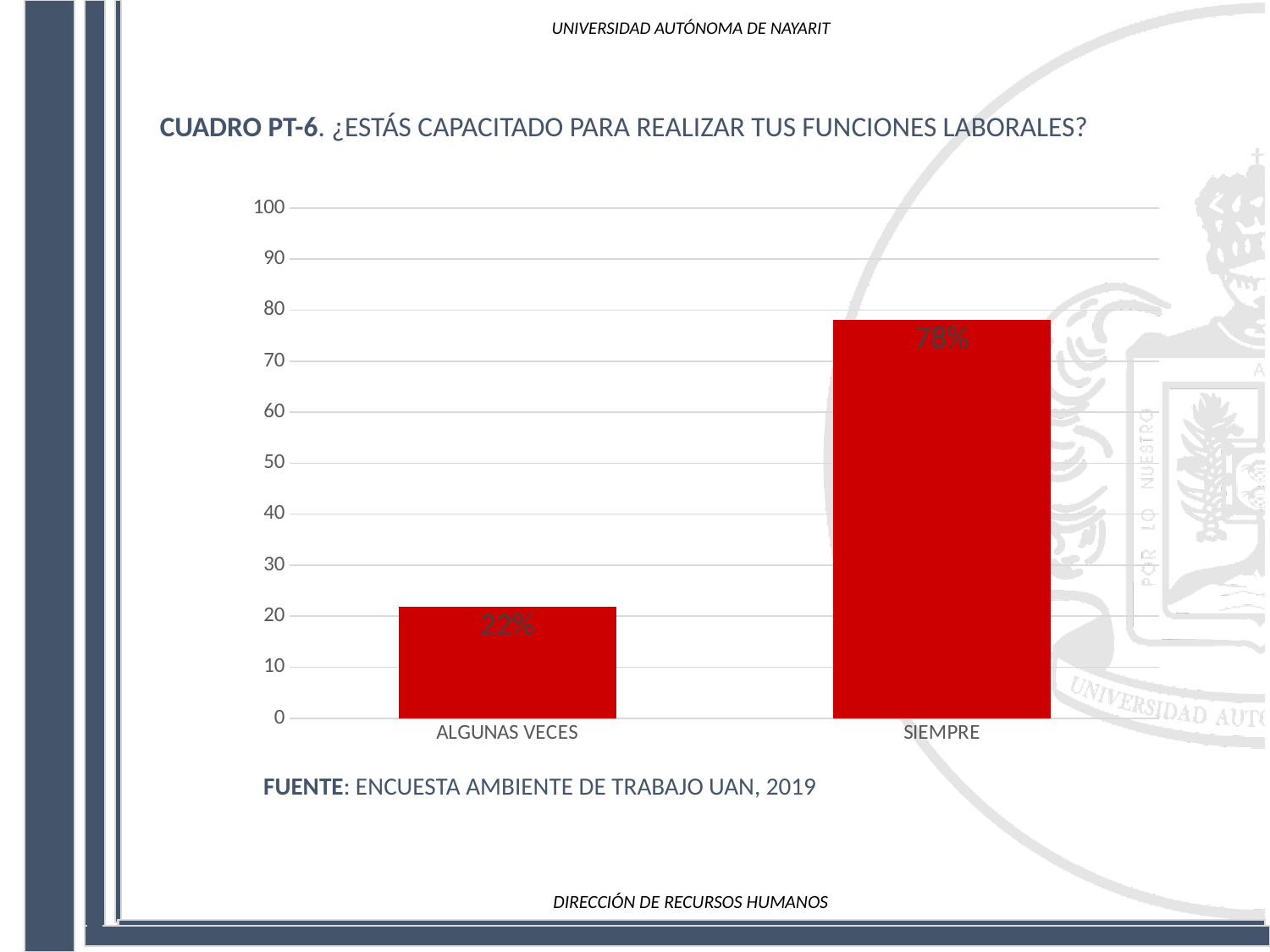
Is the value for SIEMPRE greater or less than 70? greater Which category has the highest value? SIEMPRE What is the title of the chart? CUADRO PT-6. ¿ESTÁS CAPACITADO PARA REALIZAR TUS FUNCIONES LABORALES? What is the value for ALGUNAS VECES? 22% What is the difference between the values for SIEMPRE and ALGUNAS VECES? 56% What kind of chart is shown on the slide? Bar chart Which category has the lowest value? ALGUNAS VECES What is the value for SIEMPRE? 78% Is the value for ALGUNAS VECES greater or less than 30? less How many categories are shown on the x axis? 2 What is the source cited below the chart? ENCUESTA AMBIENTE DE TRABAJO UAN, 2019 Which is larger, the value for ALGUNAS VECES or the value for SIEMPRE? SIEMPRE